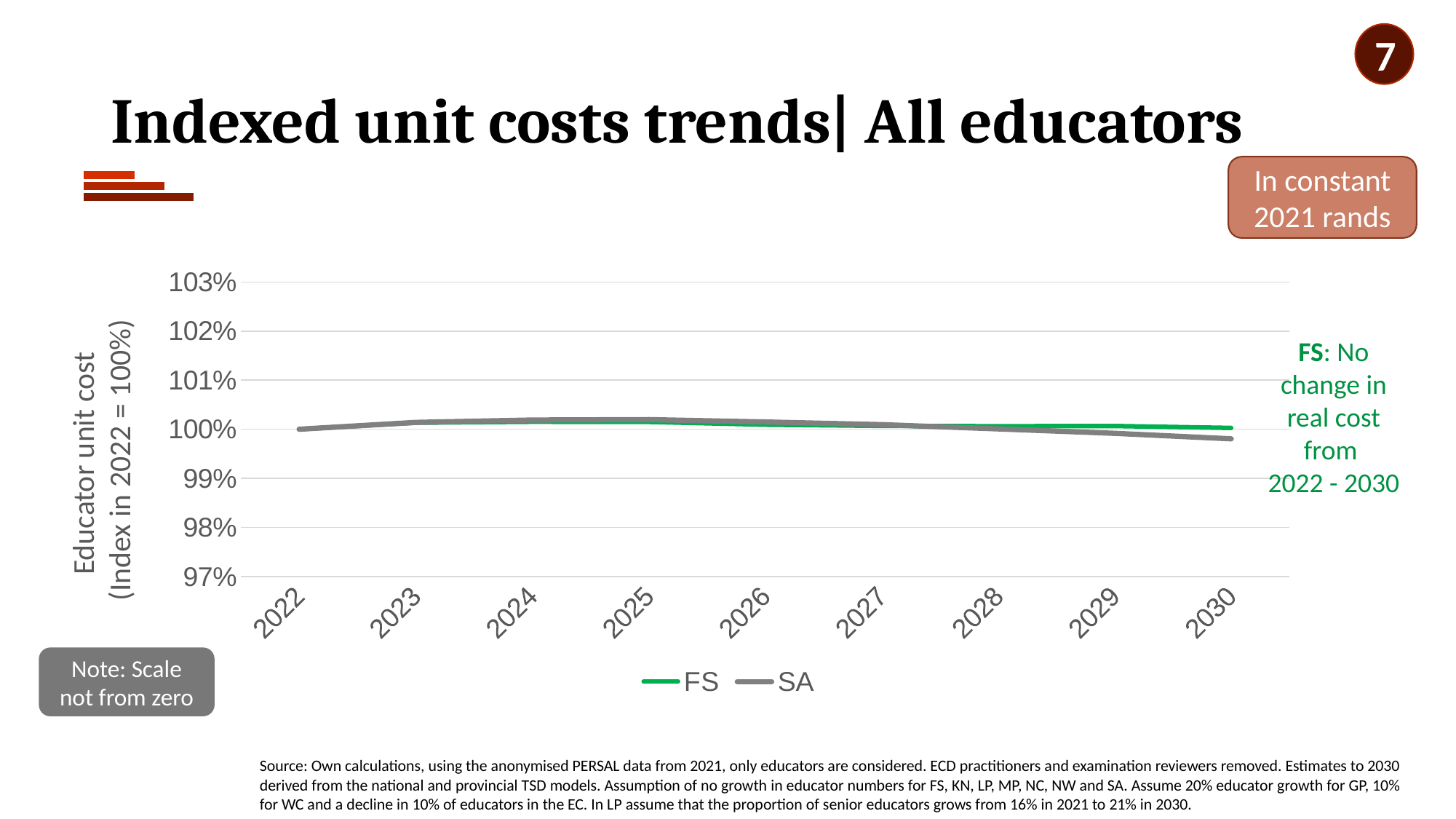
Which series are listed in the chart legend? FS and SA What kind of chart is shown on the slide? line chart What is the highest value shown on the y axis of the chart? 103% In 2030, which series has the higher value, FS or SA? FS How many series does the chart legend list? 2 Is the value for SA in 2030 greater or less than 100%? less What is the first year shown on the x axis? 2022 How many years are shown along the x axis of the chart? 9 Is the value for FS in 2025 greater or less than 101%? less Does the SA line rise or fall between 2025 and 2030? fall Is the value for SA in 2028 greater or less than 99%? greater